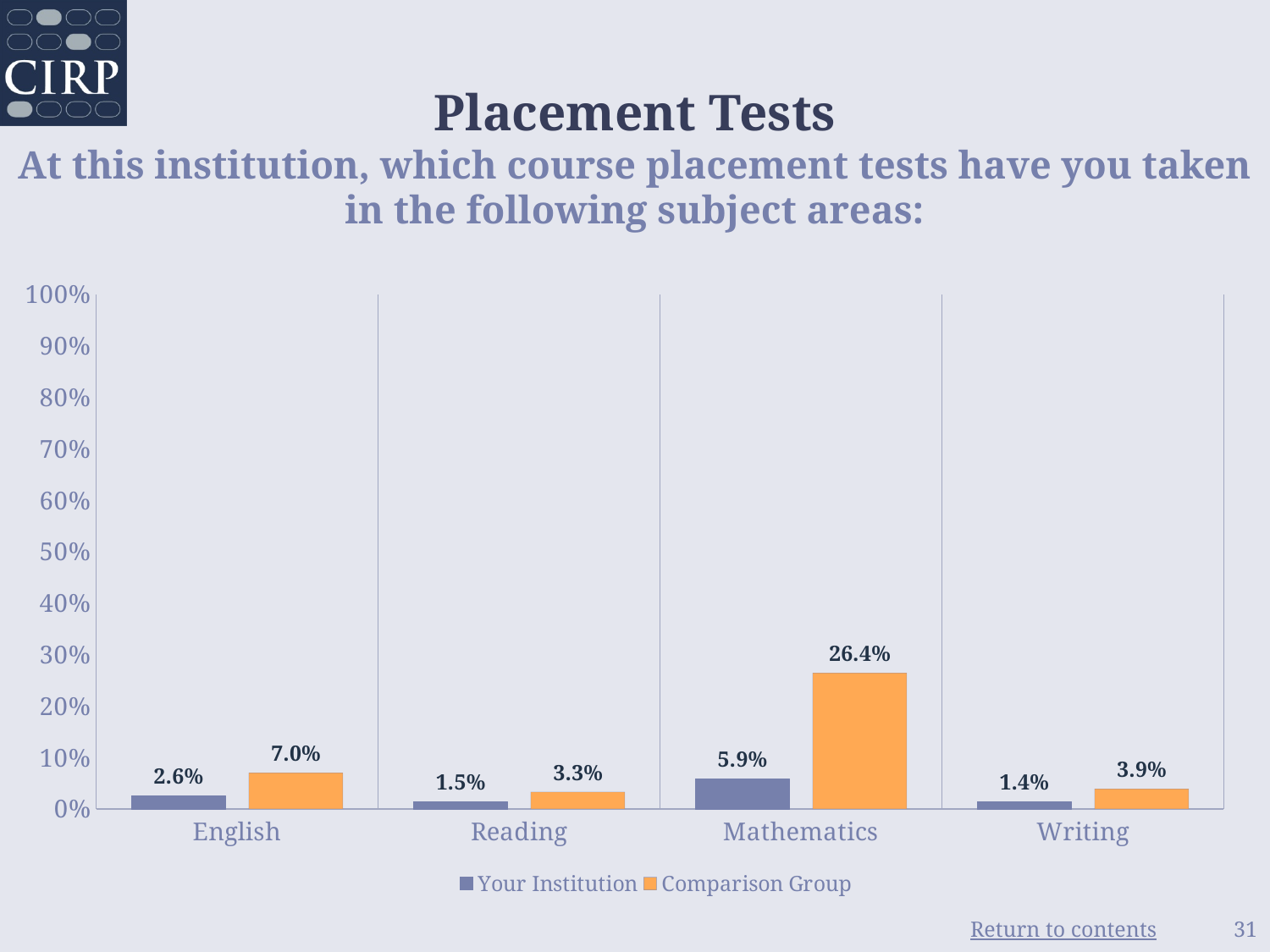
Which subject area has the lowest value for Your Institution? Writing What is the difference between the Comparison Group and Your Institution values in Mathematics? 20.5% What kind of chart is shown on the slide? Bar chart Which is larger: Your Institution's value for English or for Reading? English How many series does the legend list? 2 What is the value for Your Institution in Writing? 1.4% Which subject area has the highest value for the Comparison Group? Mathematics Is the Comparison Group value for Mathematics greater or less than 20%? greater What is the difference between the Comparison Group values for English and Reading? 3.7% What is the value for Your Institution in Mathematics? 5.9% What is the value for the Comparison Group in English? 7.0% How many subject areas are shown on the x axis? 4